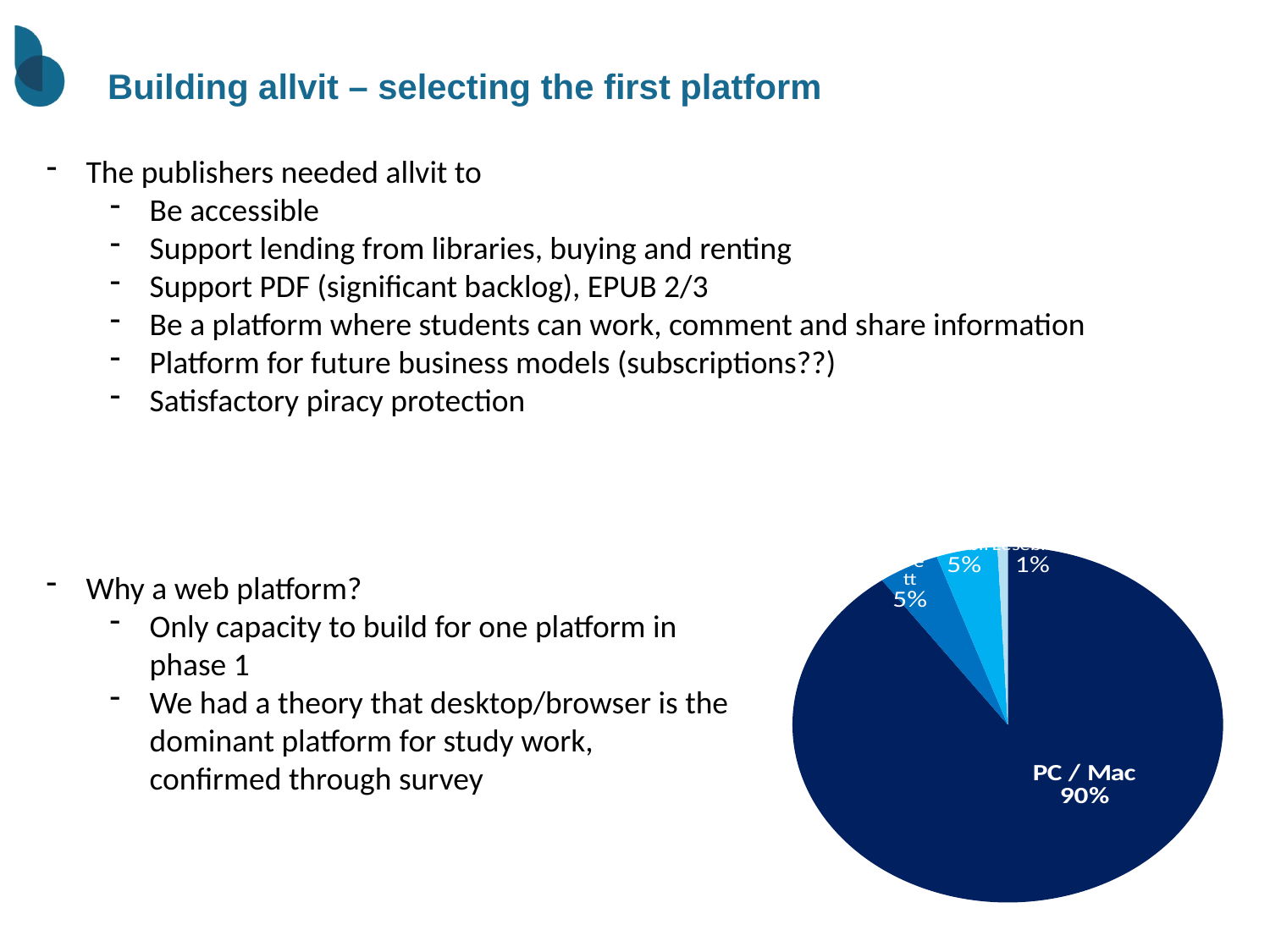
What is the difference in percentage points between the PC / Mac slice and the smallest slice? 89 What is the value of the smallest slice in the pie chart? 1% How many slices in the pie chart are labelled 5%? 2 What colour is the PC / Mac slice in the pie chart? dark navy blue Which category has the largest slice in the pie chart? PC / Mac What kind of chart is shown on the slide? pie chart Where on the slide is the pie chart positioned? bottom right What share of the pie chart does PC / Mac have? 90% Is the PC / Mac slice larger or smaller than the 5% slices? larger How many slices does the pie chart have? 4